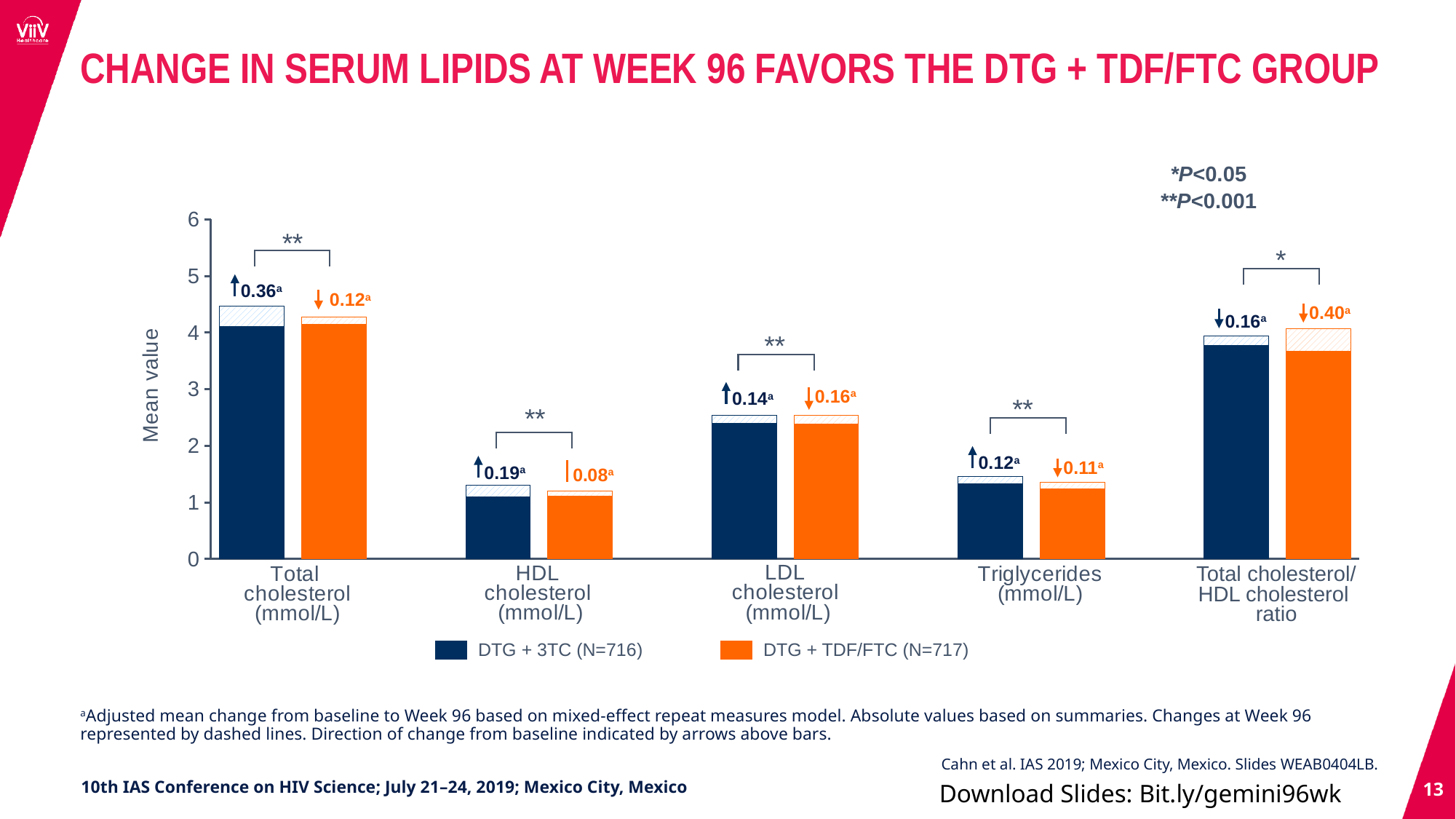
Which category has the highest mean value bars? Total cholesterol (mmol/L) What kind of chart is shown on the slide? bar chart What is the labelled change from baseline for Triglycerides in the DTG + TDF/FTC group? 0.11 What is the labelled change from baseline for Total cholesterol in the DTG + 3TC group? 0.36 How many series does the legend list? 2 What is the labelled change from baseline for Total cholesterol/HDL cholesterol ratio in the DTG + TDF/FTC group? 0.40 What is the label on the y axis? Mean value Which category has the lowest mean value bars? HDL cholesterol (mmol/L) How many lipid categories are shown along the x axis? 5 Is the mean value for LDL cholesterol in the DTG + TDF/FTC group greater or less than 2? greater What is the labelled change from baseline for HDL cholesterol in the DTG + 3TC group? 0.19 Is the mean value for Triglycerides in the DTG + 3TC group greater or less than 2? less